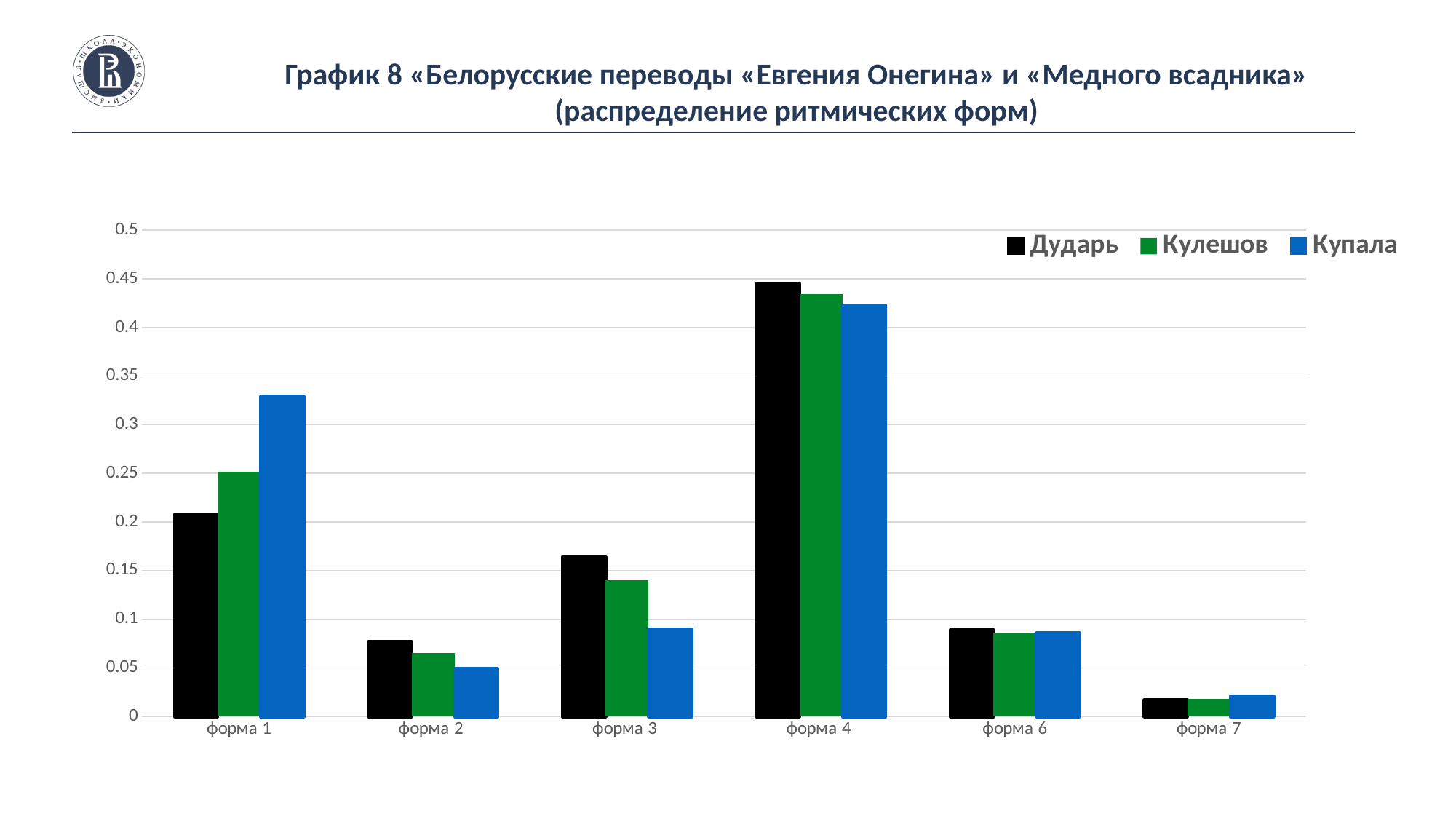
In форма 1, which series has the larger value, Купала or Дударь? Купала How many categories (forms) are shown on the x axis? 6 Which series are listed in the legend? Дударь, Кулешов, Купала In форма 3, which series has the larger value, Дударь or Купала? Дударь Is the value for Дударь in форма 4 greater or less than 0.4? greater For the series Купала, which category has the lowest value? форма 7 What kind of chart is shown on the slide? bar chart What colour represents the series Кулешов? green How many series does the legend list? 3 Is the value for Купала in форма 1 greater or less than 0.3? greater For the series Дударь, which category has the highest value? форма 4 Is the value for Дударь in форма 2 greater or less than 0.1? less